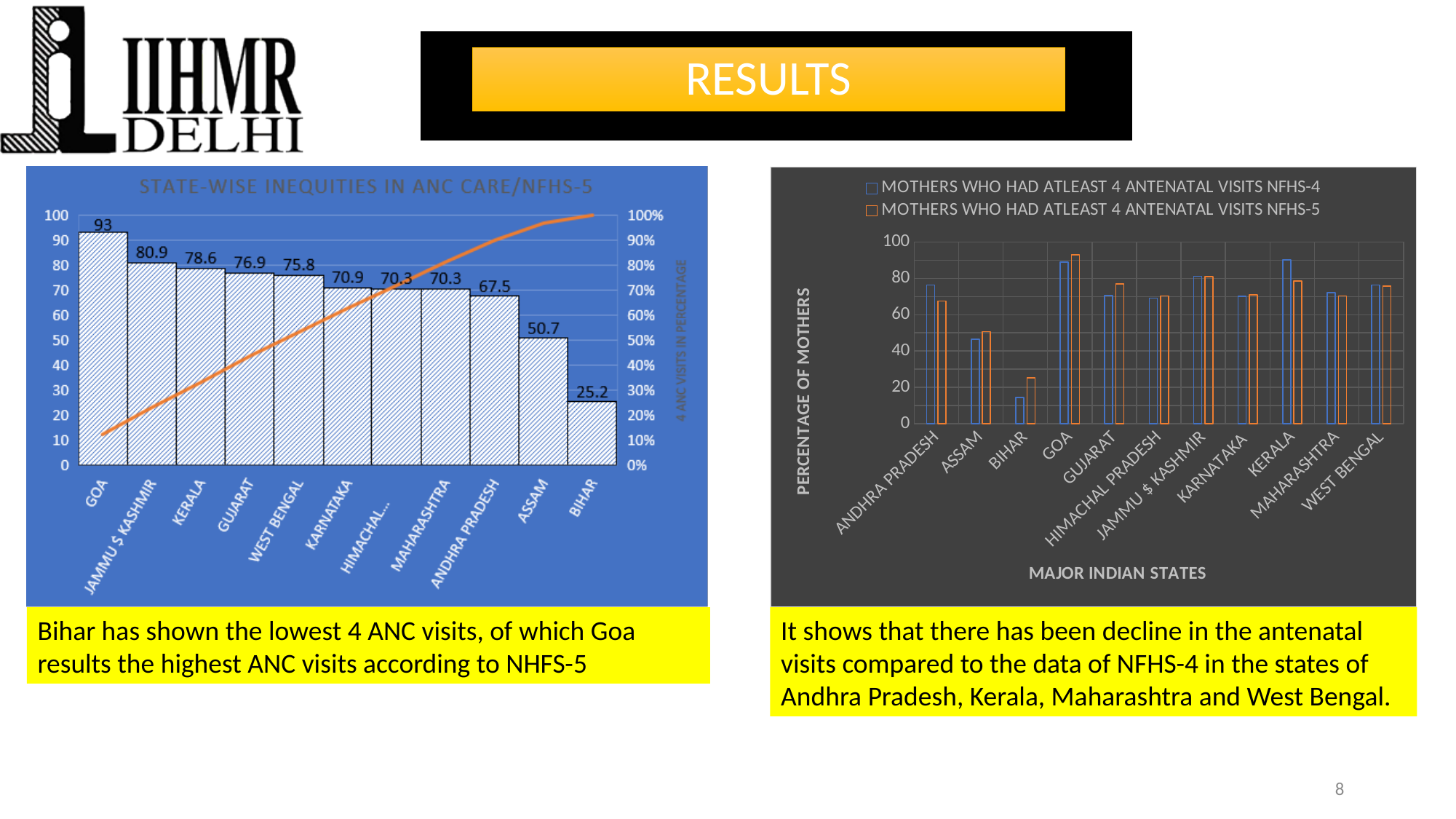
In the chart titled 'STATE-WISE INEQUITIES IN ANC CARE/NFHS-5', which state has the lowest value? Bihar In the chart titled 'STATE-WISE INEQUITIES IN ANC CARE/NFHS-5', which is larger, the value for Assam or the value for Andhra Pradesh? Andhra Pradesh In the chart titled 'STATE-WISE INEQUITIES IN ANC CARE/NFHS-5', what is the value for Bihar? 25.2 In the chart on the right of the slide, is the value for Goa in the NFHS-5 series greater or less than 80? greater In the chart titled 'STATE-WISE INEQUITIES IN ANC CARE/NFHS-5', what is the value for West Bengal? 75.8 In the chart on the right of the slide, is the value for Bihar in the NFHS-4 series greater or less than 20? less How many series does the legend list in the chart on the right of the slide? 2 In the chart titled 'STATE-WISE INEQUITIES IN ANC CARE/NFHS-5', what is the value for Goa? 93 What kind of chart is the chart on the right of the slide? Bar chart In the chart titled 'STATE-WISE INEQUITIES IN ANC CARE/NFHS-5', what is the difference between the values for Goa and Bihar? 67.8 In the chart titled 'STATE-WISE INEQUITIES IN ANC CARE/NFHS-5', which state has the highest value? Goa How many states are shown in the chart titled 'STATE-WISE INEQUITIES IN ANC CARE/NFHS-5'? 11